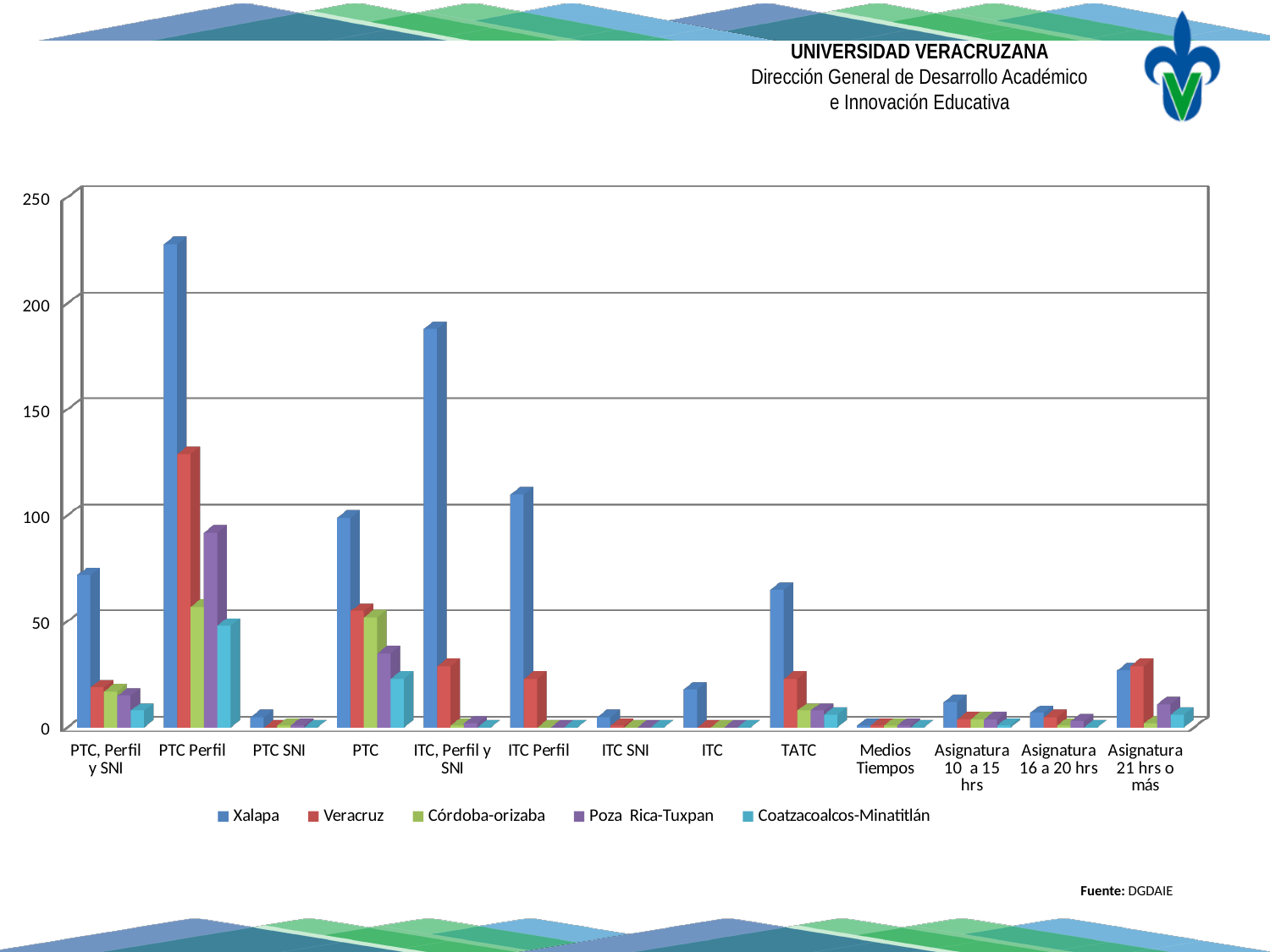
How many categories are shown along the x axis of the chart? 13 In which category does the Xalapa series reach its highest value? PTC Perfil Is the value for Veracruz in the PTC Perfil category greater or less than 100? greater Is the value for Xalapa in the PTC Perfil category greater or less than 200? greater Is the value for Xalapa in the ITC, Perfil y SNI category greater or less than 150? greater Which series is shown in blue in the chart's legend? Xalapa In the PTC Perfil category, which is larger: the value for Poza Rica-Tuxpan or the value for Córdoba-orizaba? Poza Rica-Tuxpan How many series does the chart's legend list? 5 In the PTC Perfil category, which is larger: the value for Xalapa or the value for Veracruz? Xalapa What kind of chart is shown on the slide? bar chart Which series is listed last in the chart's legend? Coatzacoalcos-Minatitlán